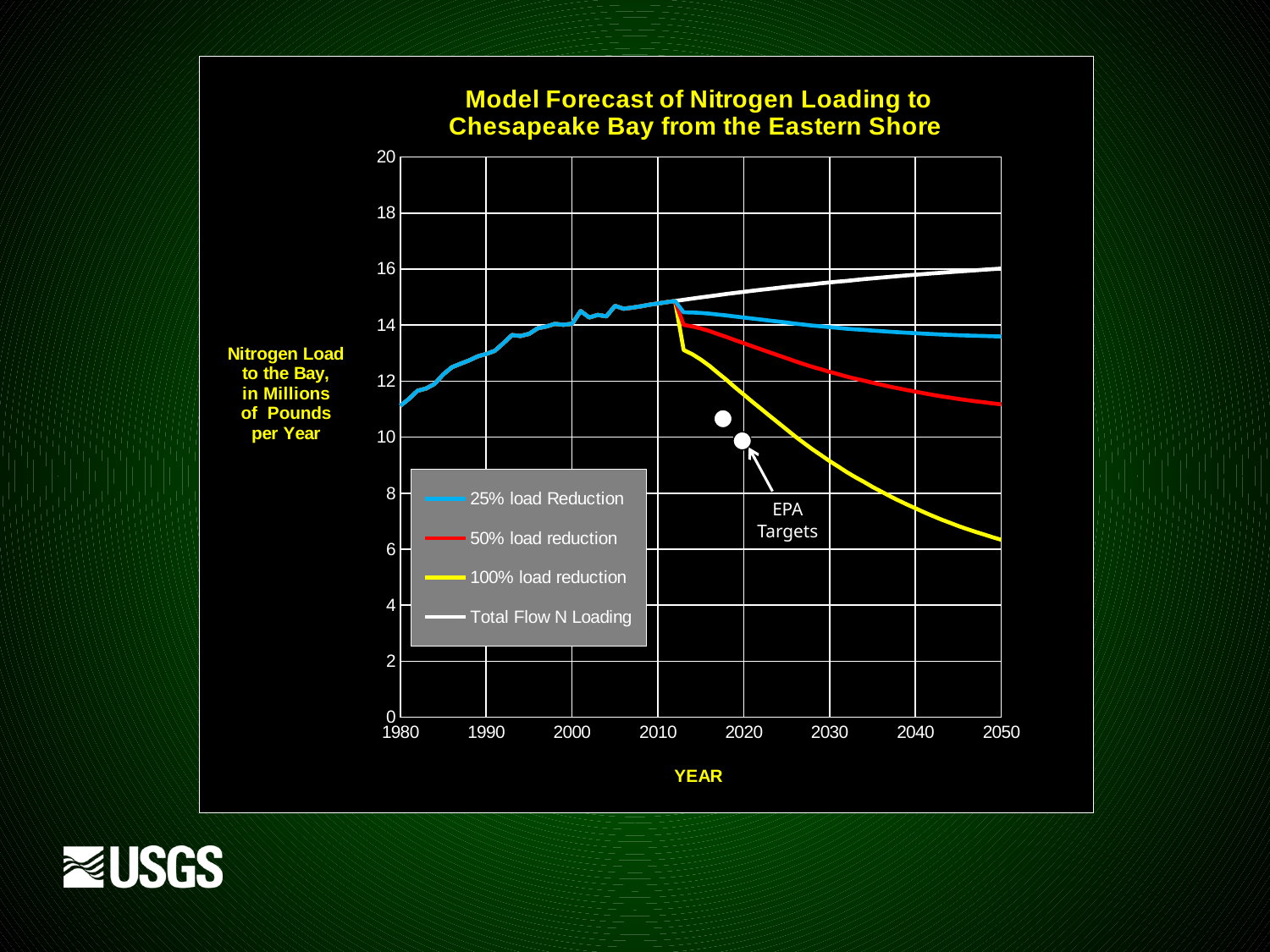
Is the value for 50% load reduction in 2050 greater or less than 12? less What is the label of the x axis? YEAR Is the value for 100% load reduction in 2050 greater or less than 8? less What is the title of the chart? Model Forecast of Nitrogen Loading to Chesapeake Bay from the Eastern Shore Which series has the highest value in 2050? Total Flow N Loading Is the value for Total Flow N Loading in 2050 greater or less than 14? greater In 2050, which is larger: the 25% load Reduction value or the 50% load reduction value? 25% load Reduction How many series does the legend list? 4 Does the 100% load reduction series rise or fall between 2010 and 2050? fall What kind of chart is shown on the slide? line chart Does the Total Flow N Loading series rise or fall between 2010 and 2050? rise Which series has the lowest value in 2050? 100% load reduction